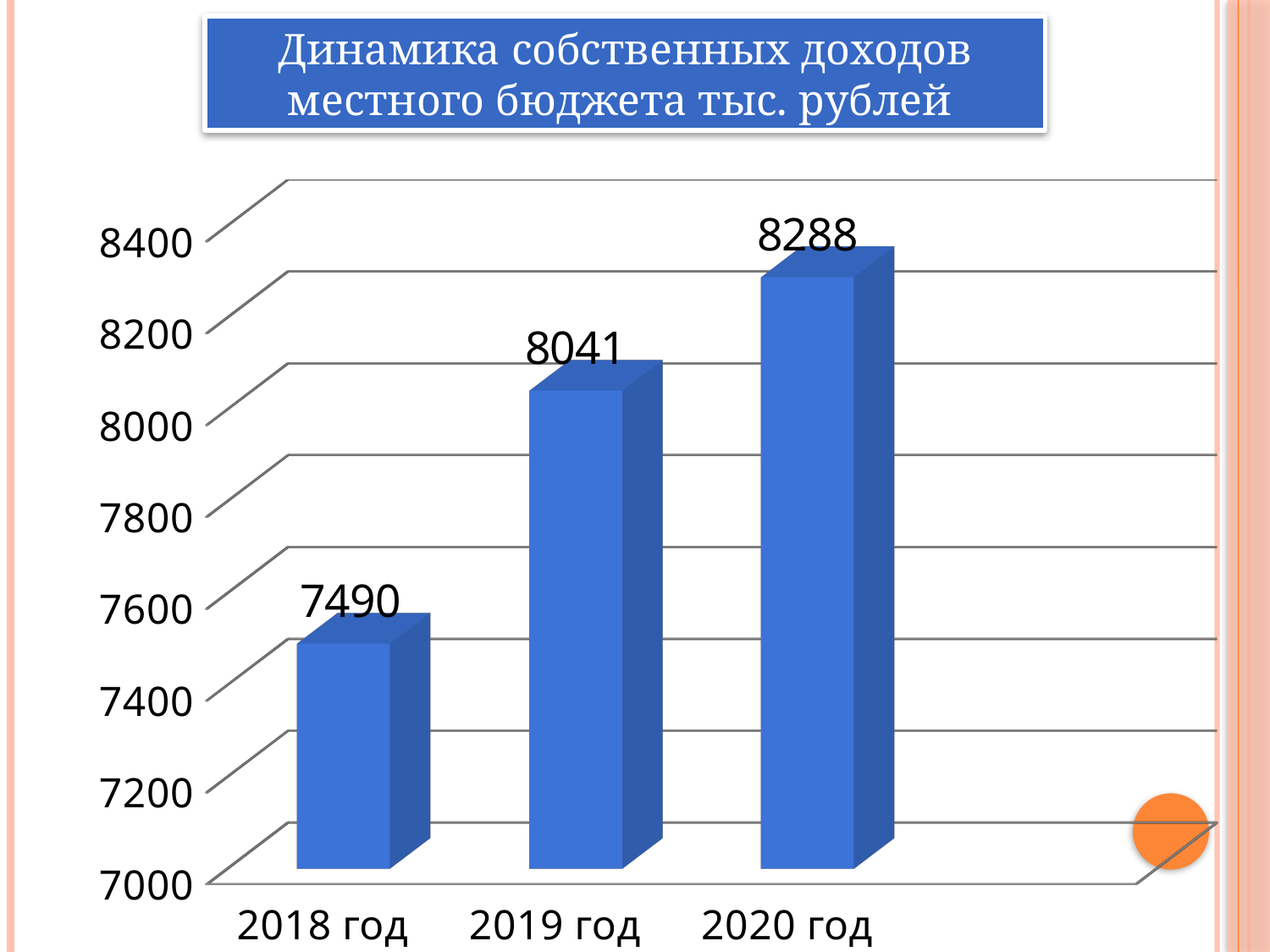
What kind of chart is shown on the slide? bar chart Which is larger, the value for 2018 год or the value for 2019 год? 2019 год What is the value for 2020 год? 8288 Which year has the lowest value? 2018 год Do the values rise or fall from 2018 год to 2020 год? rise What is the value for 2019 год? 8041 What is the difference between the values for 2020 год and 2019 год? 247 Is the value for 2018 год greater or less than 7600? less What is the value for 2018 год? 7490 Which year has the highest value? 2020 год How many years are shown on the chart? 3 What is the difference between the values for 2019 год and 2018 год? 551